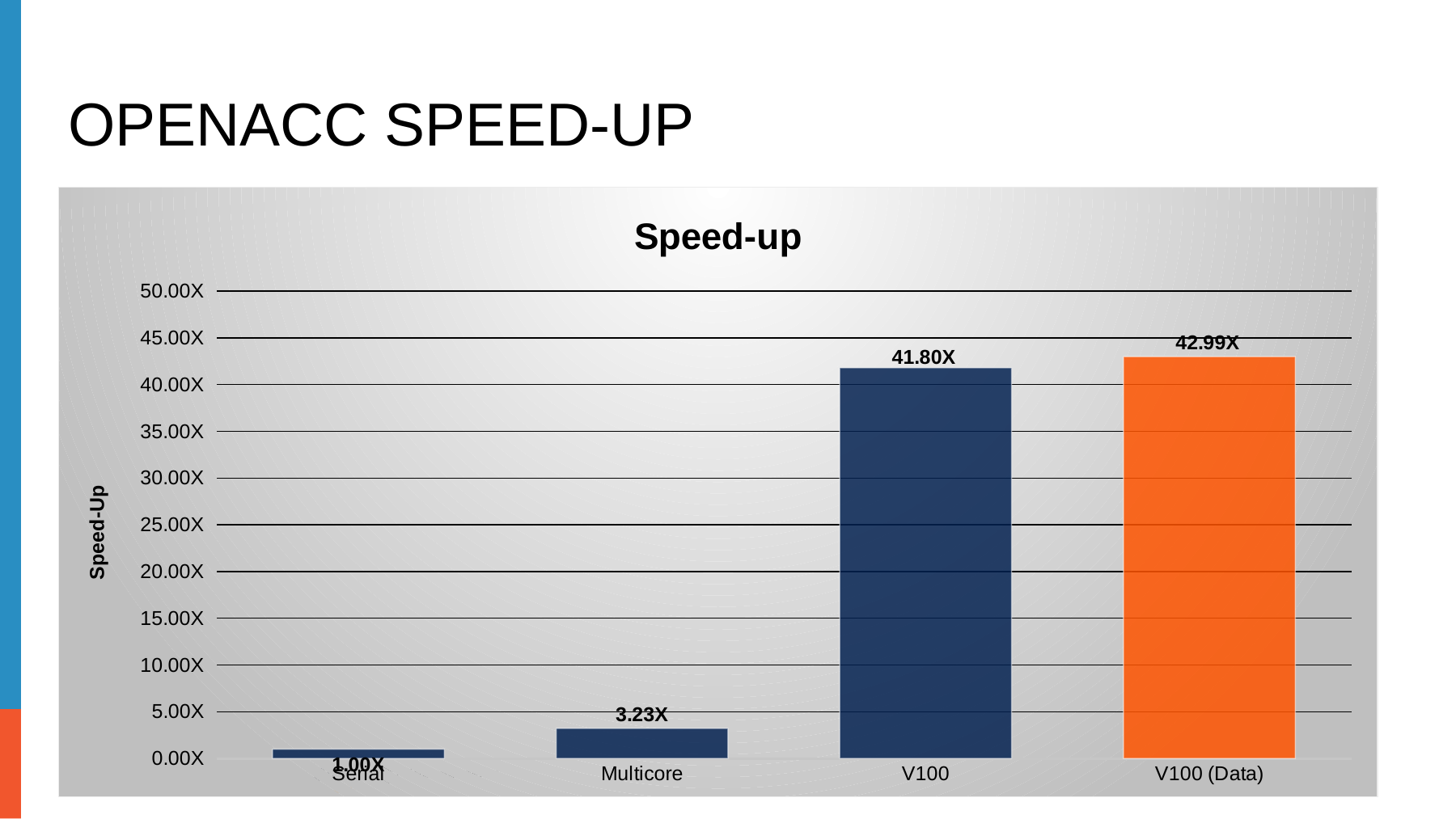
What is the speed-up value for V100? 41.80X Is the speed-up for V100 greater or less than 40.00X? greater How many categories are shown on the x axis? 4 What is the speed-up value for Serial? 1.00X What is the difference between the speed-up for V100 (Data) and V100? 1.19X What type of chart is shown on the slide? Bar chart What is the speed-up value for V100 (Data)? 42.99X Which category has the highest speed-up? V100 (Data) Which has a larger speed-up, V100 or V100 (Data)? V100 (Data) What is the speed-up value for Multicore? 3.23X Which category has the lowest speed-up? Serial What is the difference between the speed-up for Multicore and Serial? 2.23X